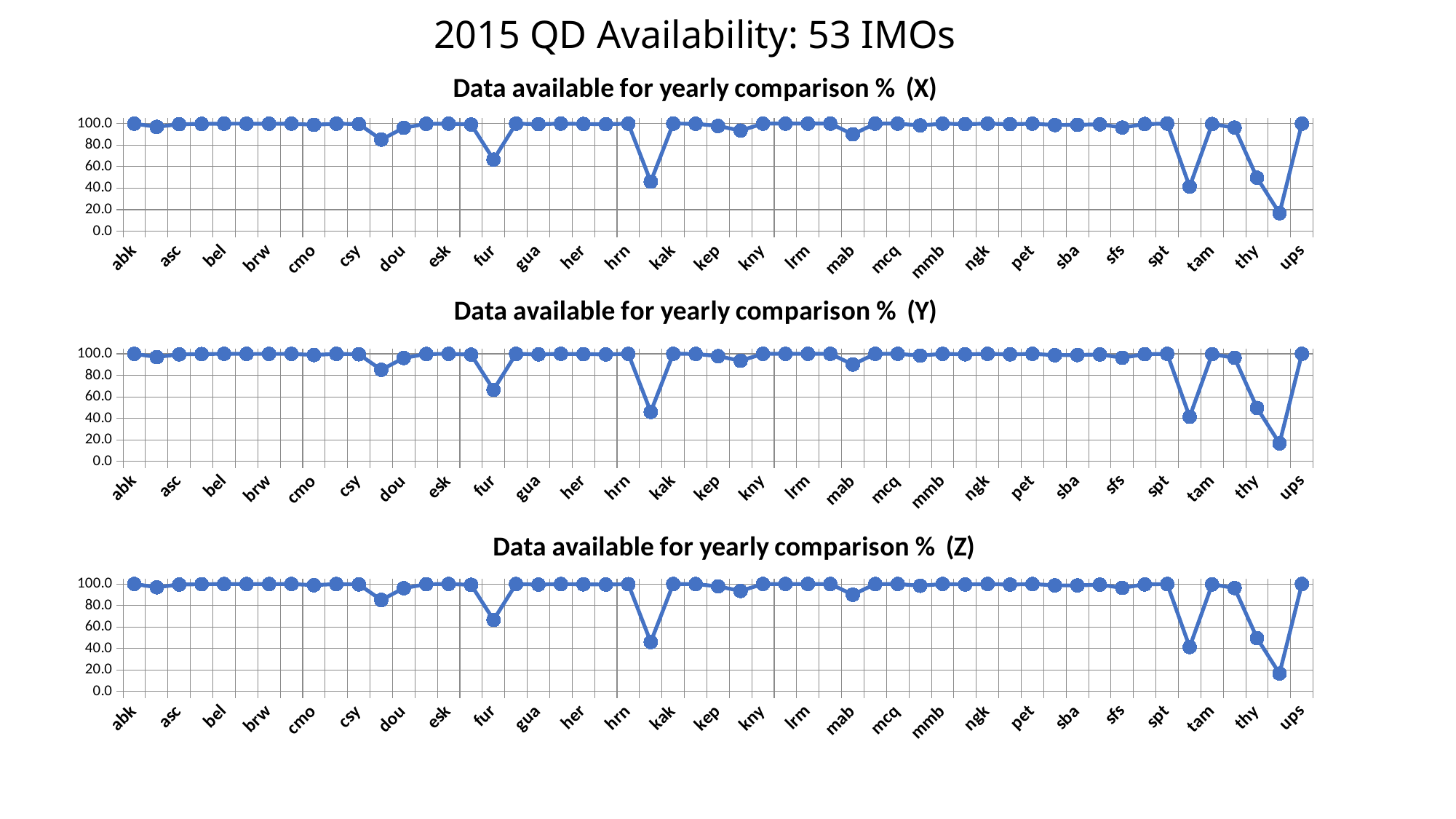
In the 'Data available for yearly comparison % (Y)' chart, which is higher, fur or thy? fur In the 'Data available for yearly comparison % (Y)' chart, is the value for thy greater or less than 60? less In the 'Data available for yearly comparison % (Z)' chart, is the value for mab greater or less than 80? greater How many IMOs does the slide title say are covered by the charts? 53 In the 'Data available for yearly comparison % (X)' chart, is the value for fur greater or less than 80? less What is the title of the bottom chart on the slide? Data available for yearly comparison % (Z) How many charts are shown on the slide? 3 In the 'Data available for yearly comparison % (X)' chart, which is lower, fur or ups? fur What kind of chart is the 'Data available for yearly comparison % (X)' chart? line chart In the 'Data available for yearly comparison % (Z)' chart, which is higher, mab or thy? mab